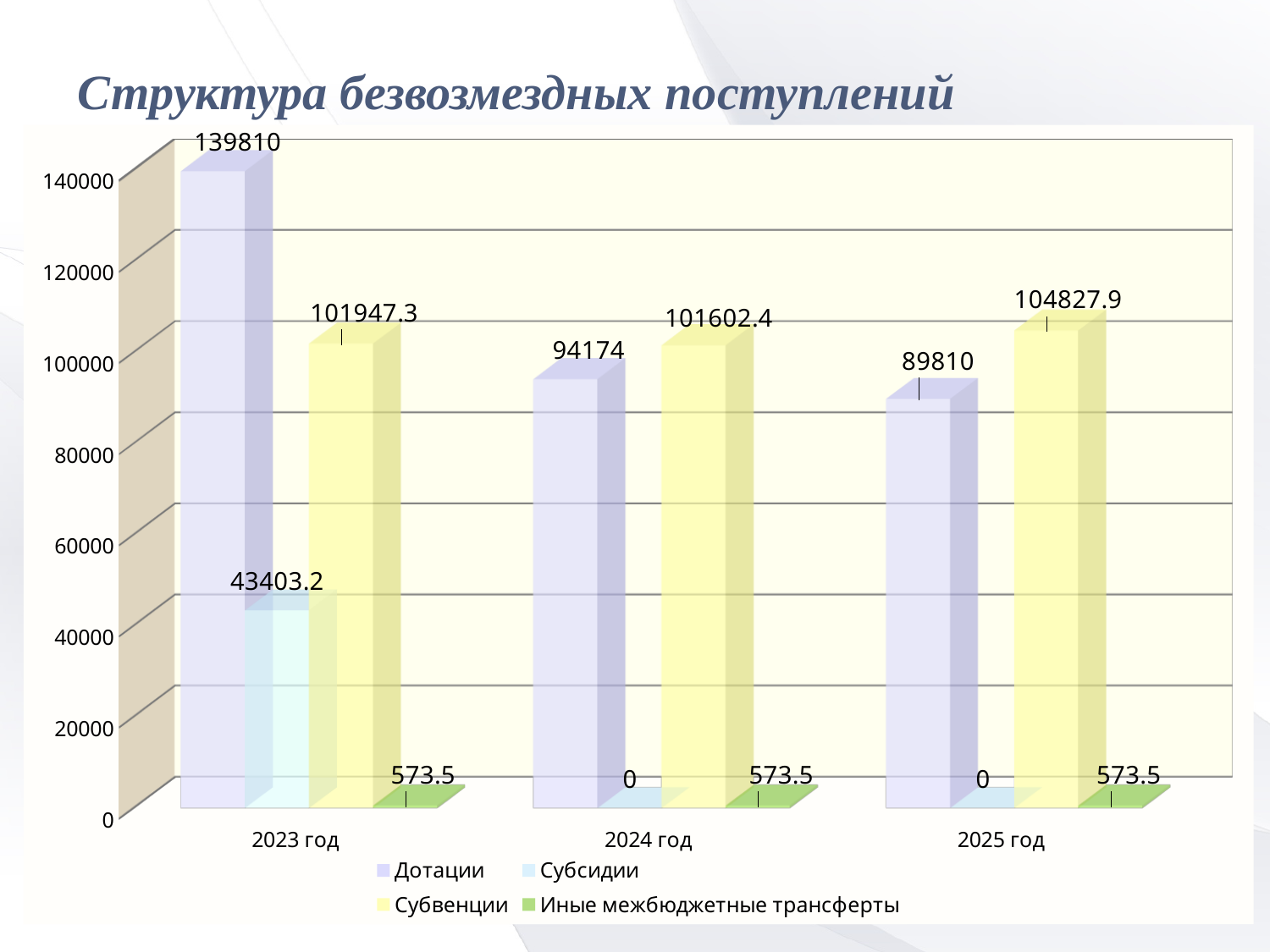
In which year is the value of Дотации the lowest? 2025 год Which is larger for 2024 год: Дотации or Субвенции? Субвенции What is the value of Иные межбюджетные трансферты for 2023 год? 573.5 In which year is the value of Дотации the highest? 2023 год How many series does the legend list? 4 How many years are shown on the x axis? 3 What is the value of Дотации for 2023 год? 139810 What is the difference between Дотации in 2023 год and Дотации in 2024 год? 45636 What is the value of Субвенции for 2025 год? 104827.9 What is the value of Субсидии for 2024 год? 0 Do the values of Дотации rise or fall from 2023 год to 2025 год? Fall What kind of chart is shown on the slide? Bar chart